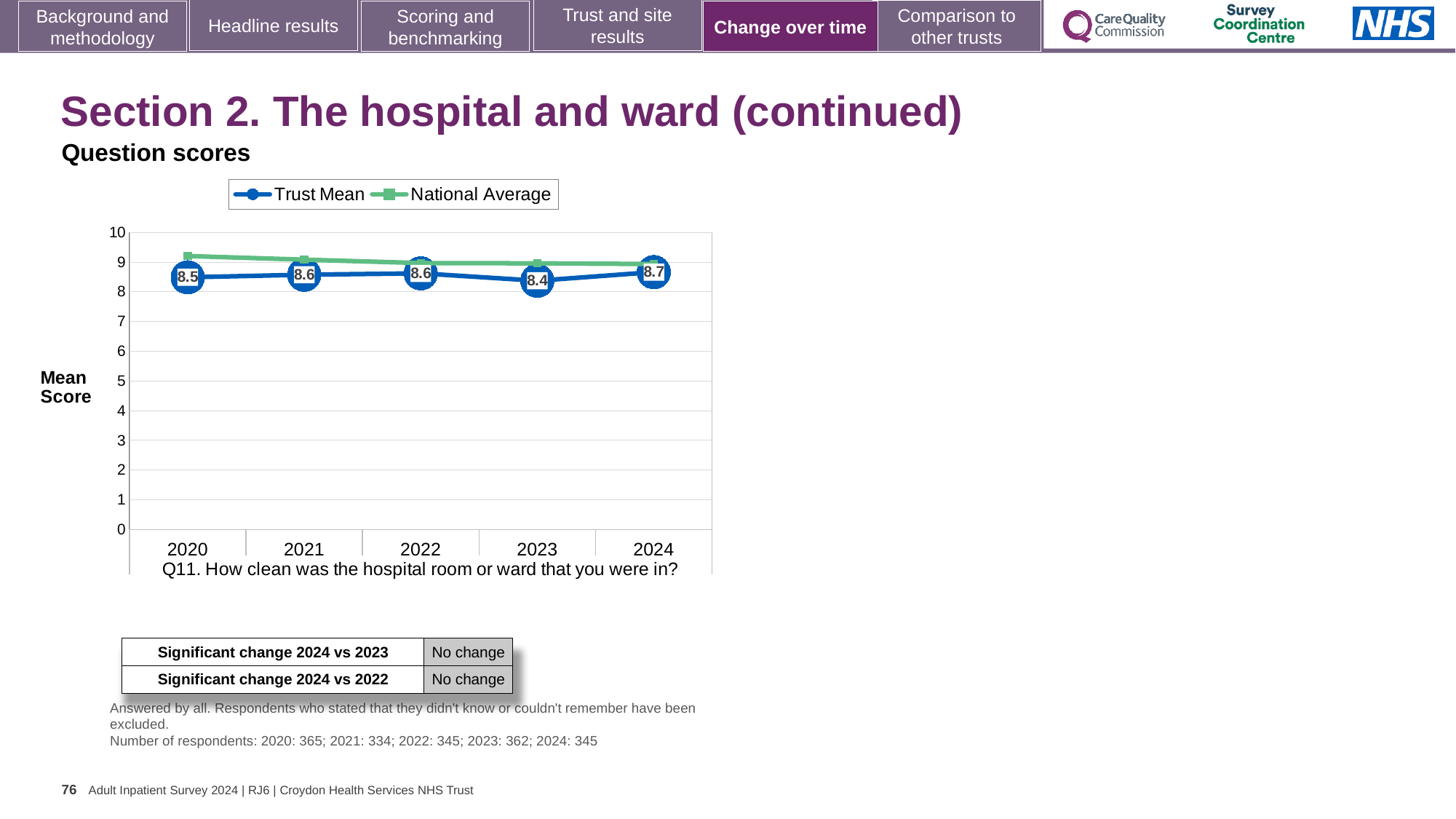
What is the Trust Mean score for 2023? 8.4 Which question does the chart show scores for? Q11. How clean was the hospital room or ward that you were in? Is the National Average value for 2020 greater or less than 8? greater What is the Trust Mean score for 2024? 8.7 What kind of chart is shown on the slide? Line chart How many years are plotted on the x axis? 5 Which is larger, the Trust Mean score for 2021 or for 2023? 2021 What is the Trust Mean score for 2020? 8.5 How many series does the legend list? 2 What is the difference between the Trust Mean scores for 2024 and 2023? 0.3 In which year is the Trust Mean score lowest? 2023 In which year is the Trust Mean score highest? 2024